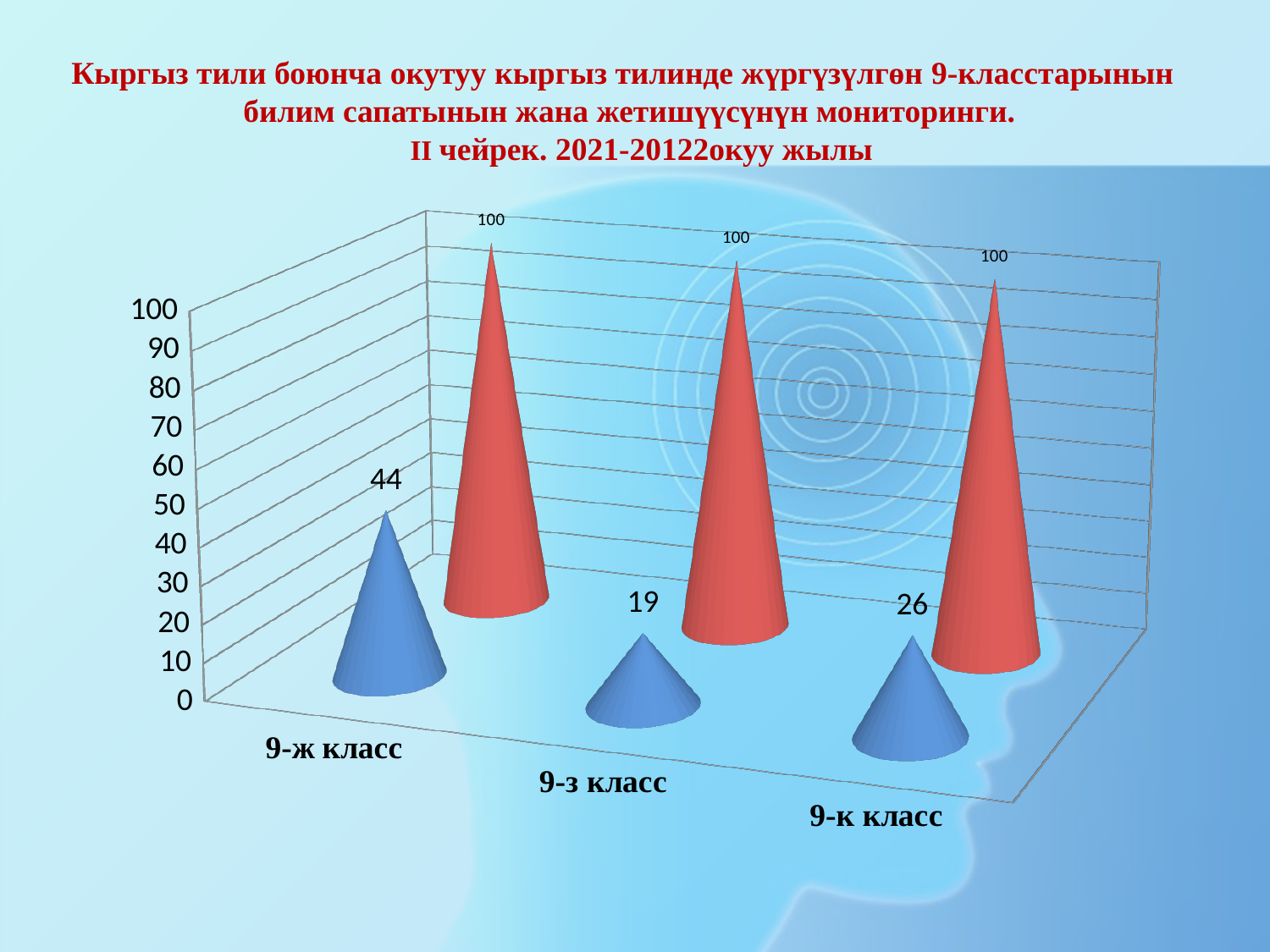
What is the maximum value shown on the vertical axis of the chart? 100 How many classes are shown on the x axis of the chart? 3 Which class has the highest blue-cone value? 9-ж класс What kind of chart is shown on the slide? bar chart Which class has the lowest blue-cone value? 9-з класс What is the value of the blue cone for 9-к класс? 26 What is the value of the blue cone for 9-ж класс? 44 What is the value of the red cone for 9-з класс? 100 What is the difference between the blue-cone values for 9-ж класс and 9-з класс? 25 What is the value of the blue cone for 9-з класс? 19 What is the difference between the red and blue cone values for 9-к класс? 74 Which is larger, the blue-cone value for 9-к класс or for 9-з класс? 9-к класс